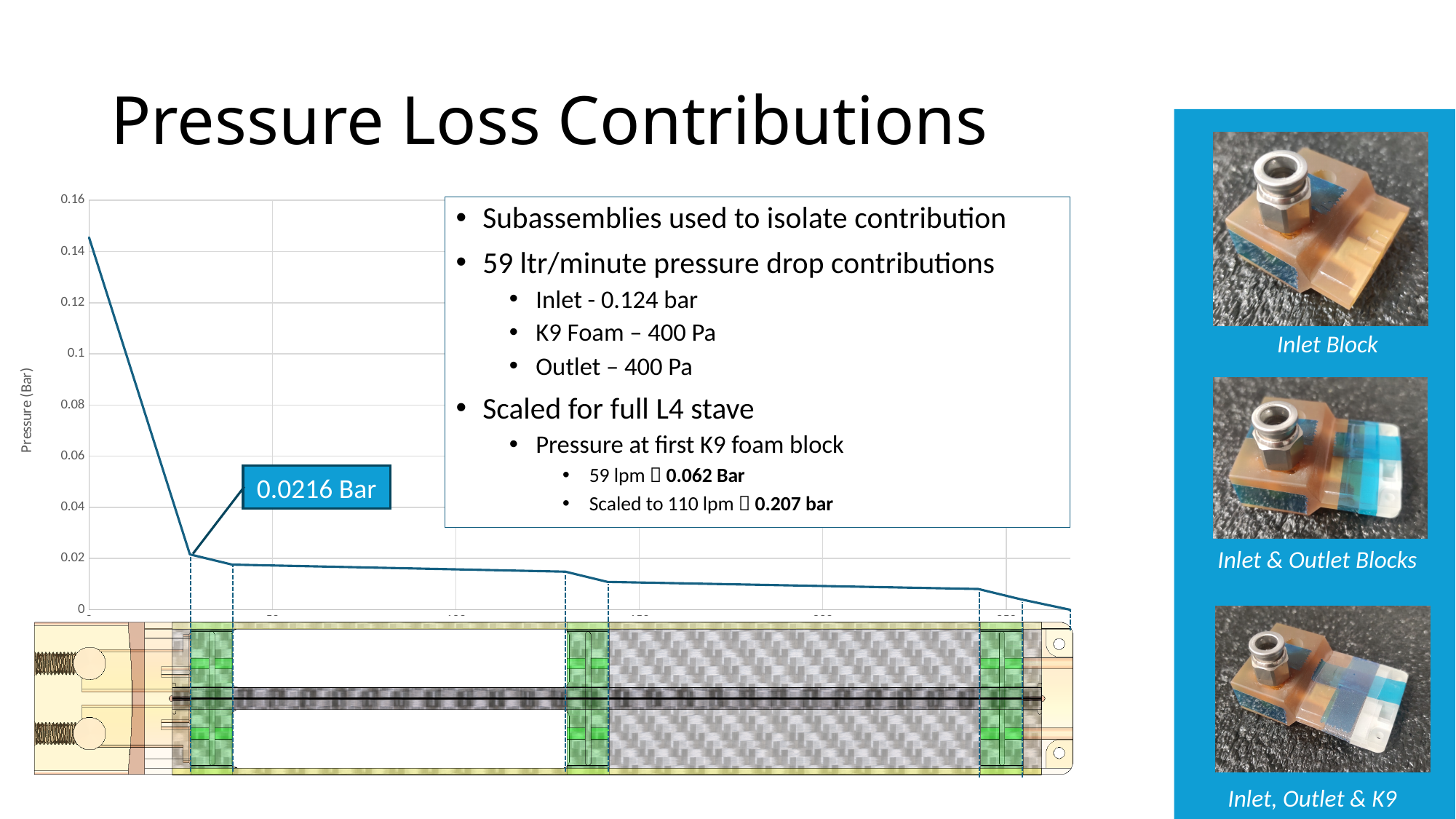
What value does the callout label on the chart give for the pressure after the inlet? 0.0216 Bar Is the pressure at the callout point (0.0216 Bar) greater or less than 0.04? less Which point on the line has the highest pressure: the leftmost point or the rightmost point? the leftmost point Is the pressure at the right end of the line greater or less than 0.02? less How many data series are plotted on the chart? 1 What is the label on the vertical axis of the chart? Pressure (Bar) Is the pressure at the start of the line (leftmost point) greater or less than 0.12? greater Does the pressure rise or fall along the x axis of the chart? fall What is the highest tick value shown on the vertical axis of the chart? 0.16 What kind of chart is shown on the slide? line chart